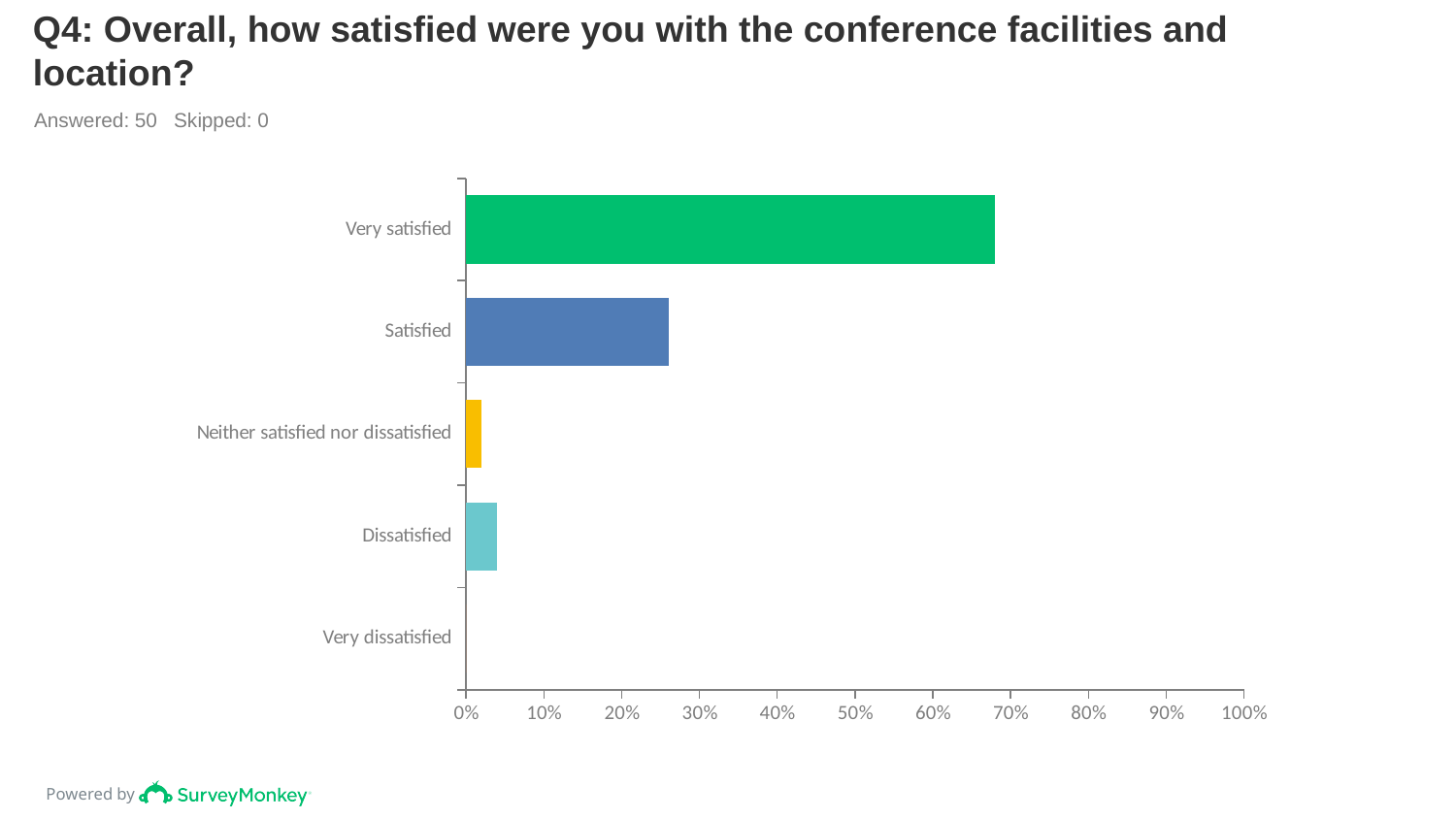
Which response category has the highest value? Very satisfied What kind of chart is shown on the slide? bar chart Which is larger, the value for Very satisfied or the value for Satisfied? Very satisfied Which response category has the lowest value? Very dissatisfied How many respondents answered this question according to the slide? 50 Which is larger, the value for Satisfied or the value for Dissatisfied? Satisfied Is the value for Dissatisfied greater or less than 10%? less Is the value for Very satisfied greater or less than 60%? greater Is the value for Satisfied greater or less than 30%? less How many response categories are shown on the chart? 5 What is the maximum value shown on the horizontal axis? 100%